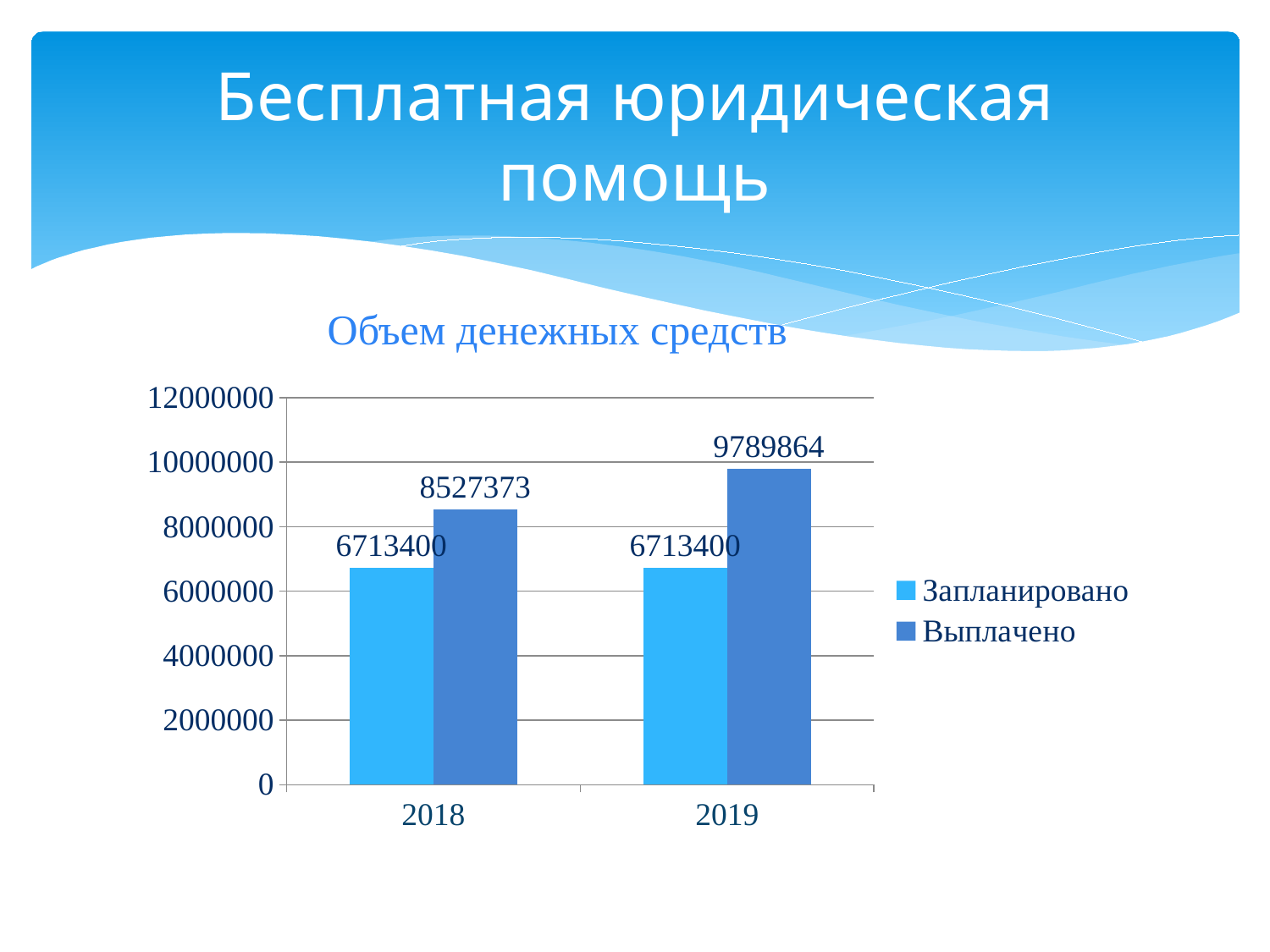
What is the title of the chart? Объем денежных средств What is the difference between Выплачено in 2019 and Выплачено in 2018? 1262491 Is the value for Выплачено in 2019 greater or less than 8000000? greater Which is larger in 2018: Запланировано or Выплачено? Выплачено What is the value for Запланировано in 2018? 6713400 How many years are shown on the x axis? 2 In which year is the Выплачено value highest? 2019 What kind of chart is shown on the slide? bar chart What is the value for Выплачено in 2018? 8527373 How many series does the legend list? 2 What is the difference between Выплачено and Запланировано in 2019? 3076464 What is the value for Выплачено in 2019? 9789864